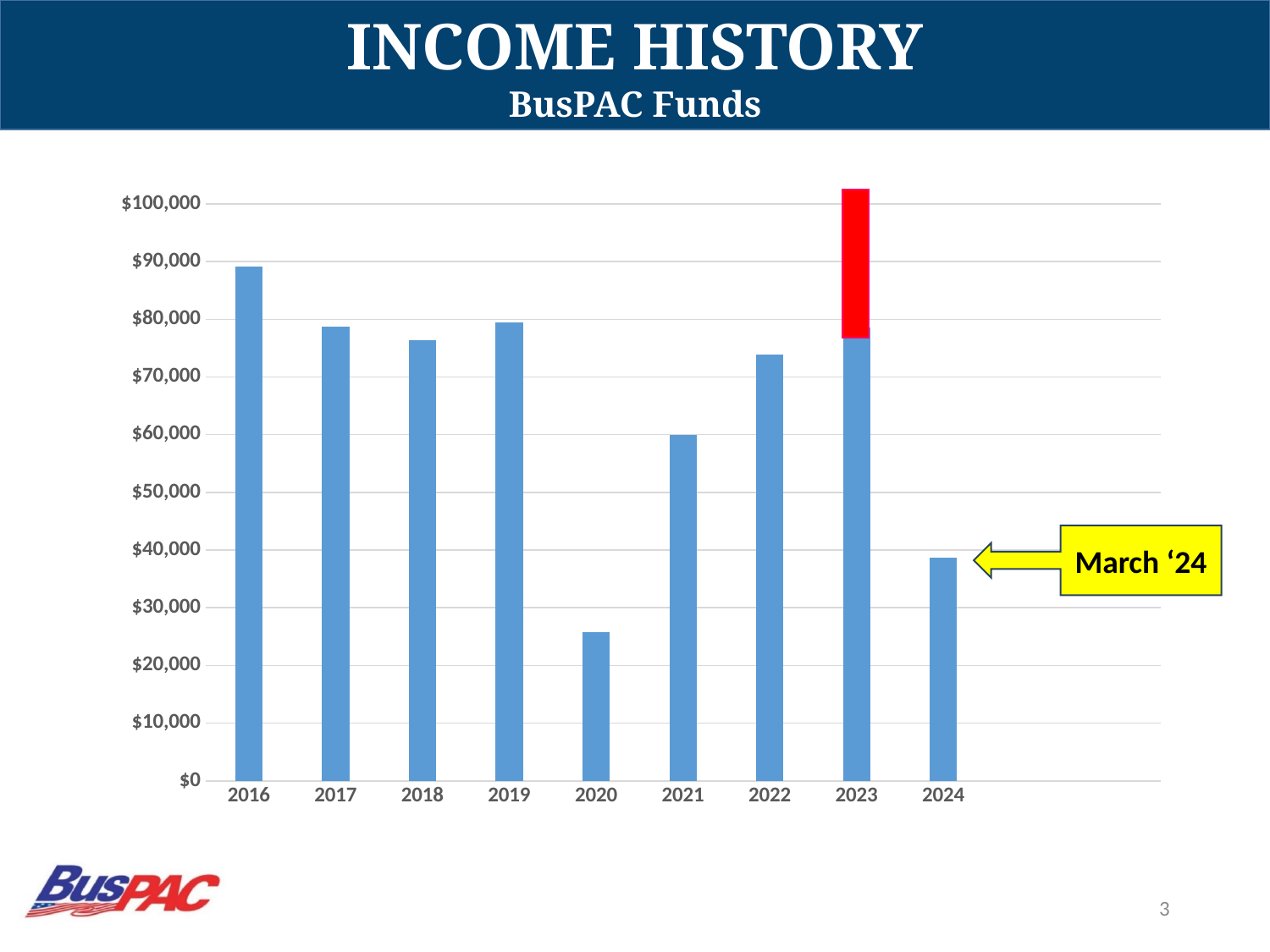
What kind of chart is shown on the slide? Bar chart Do the values rise or fall from 2020 to 2023? rise Which year has the tallest bar in the chart (including the red portion)? 2023 Is the value for 2016 greater or less than $80,000? greater Is the value for 2020 greater or less than $30,000? less Which year has the larger value, 2021 or 2022? 2022 Is the value for 2024 greater or less than $50,000? less Which year has the lowest bar in the chart? 2020 How many years are shown on the x axis of the chart? 9 Which year has the larger value, 2016 or 2017? 2016 Which year's bar does the yellow 'March '24' arrow point to? 2024